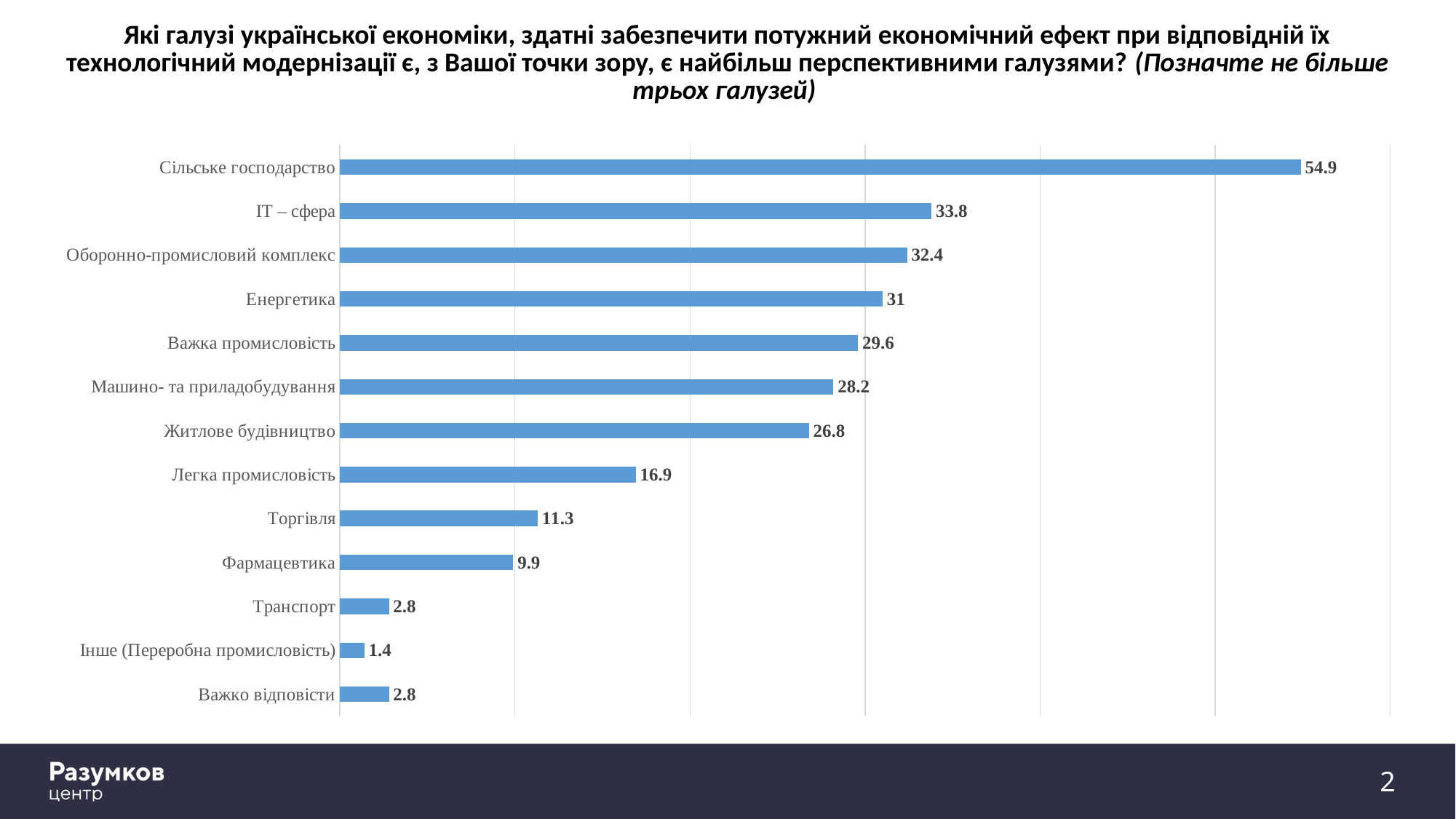
How many categories are shown in the chart? 13 What is the value for Енергетика? 31 What is the value for Сільське господарство? 54.9 Which category has the highest value? Сільське господарство Which category has the lowest value? Інше (Переробна промисловість) What kind of chart is shown on the slide? Bar chart What is the difference between the values for Легка промисловість and Торгівля? 5.6 Which is larger, the value for Важка промисловість or the value for Житлове будівництво? Важка промисловість Which is larger, the value for Транспорт or the value for Фармацевтика? Фармацевтика What is the difference between the values for Сільське господарство and ІТ – сфера? 21.1 What is the value for Фармацевтика? 9.9 What colour are the bars in the chart? Blue